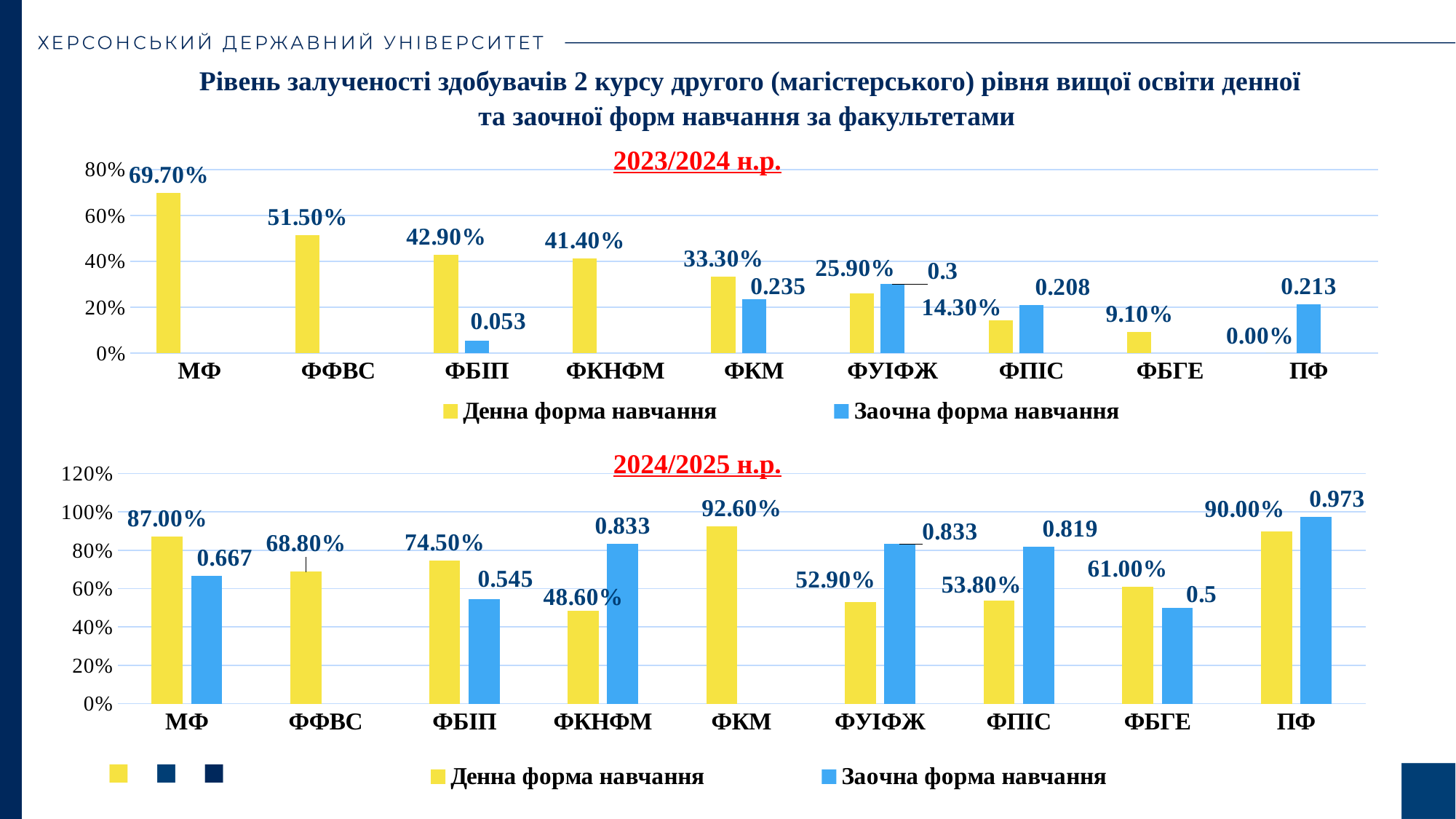
In the 2023/2024 н.р. chart, what is the value for Заочна форма навчання for ФКМ? 0.235 In the 2024/2025 н.р. chart, which faculty has the lowest Денна форма навчання value? ФКНФМ In the 2023/2024 н.р. chart, which faculty has the highest Денна форма навчання value? МФ How many faculties are shown on the x axis of the 2024/2025 н.р. chart? 9 What type of chart is the 2024/2025 н.р. chart? Bar chart In the 2023/2024 н.р. chart, which faculty has the lowest Денна форма навчання value? ПФ In the 2023/2024 н.р. chart, what is the difference between the Денна форма навчання values for МФ and ФФВС? 18.20% In the 2024/2025 н.р. chart, which is larger for ФБІП: Денна форма навчання or Заочна форма навчання? Денна форма навчання In the 2024/2025 н.р. chart, what is the value for Денна форма навчання for ФКМ? 92.60% In the 2024/2025 н.р. chart, what is the value for Заочна форма навчання for ПФ? 0.973 How many series does the legend of the 2023/2024 н.р. chart list? 2 In the 2023/2024 н.р. chart, what is the value for Денна форма навчання for МФ? 69.70%